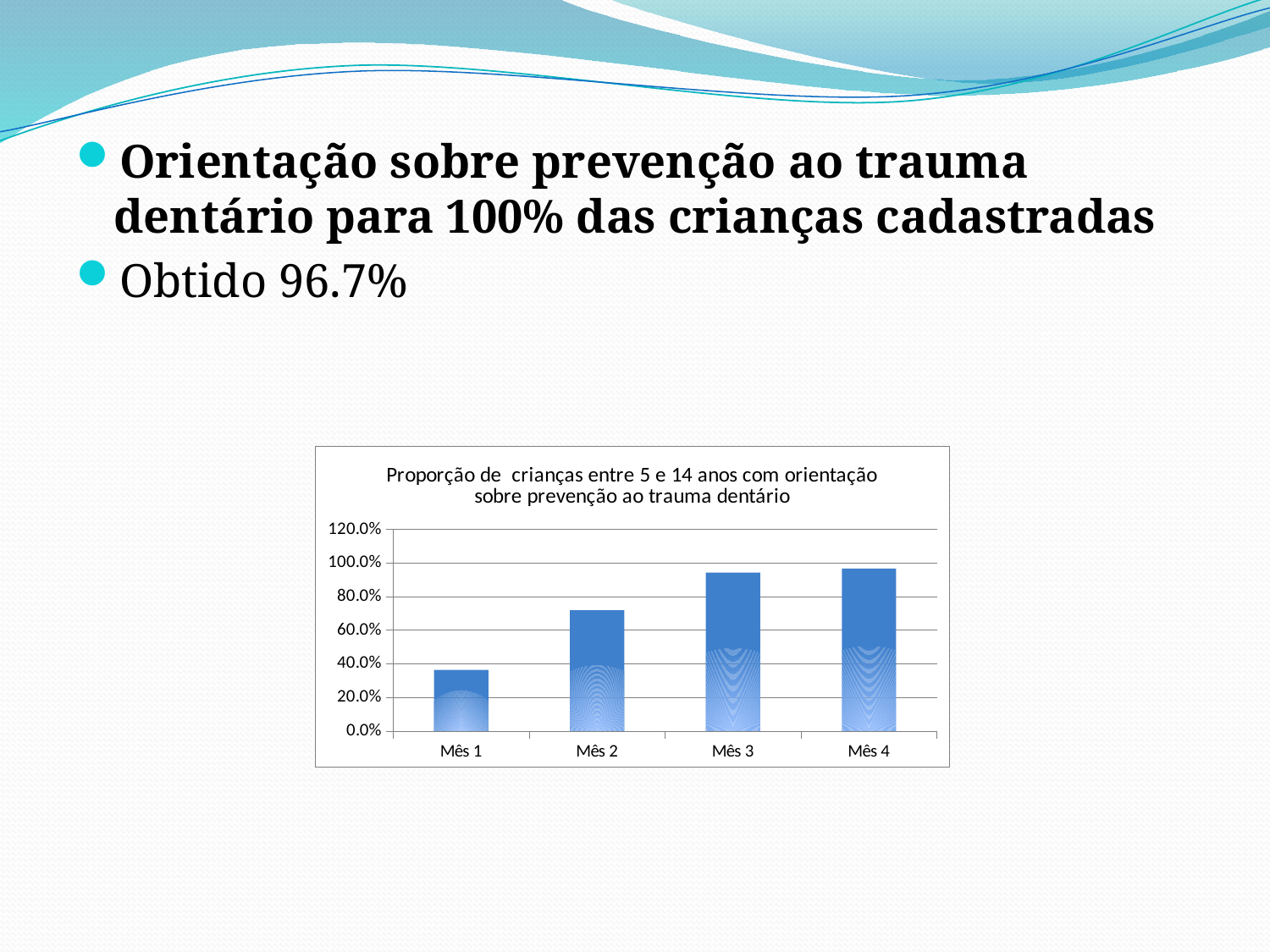
Is the value for Mês 1 greater or less than 20.0%? greater Which is larger, the value for Mês 2 or the value for Mês 4? Mês 4 Which is larger, the value for Mês 1 or the value for Mês 2? Mês 2 What kind of chart is shown on the slide? bar chart What is the title of the chart? Proporção de crianças entre 5 e 14 anos com orientação sobre prevenção ao trauma dentário Is the value for Mês 4 greater or less than 100.0%? less Which month has the lowest proportion on the chart? Mês 1 How many months (categories) are plotted on the chart? 4 Is the value for Mês 1 greater or less than 40.0%? less Do the values rise or fall from Mês 1 to Mês 4? rise